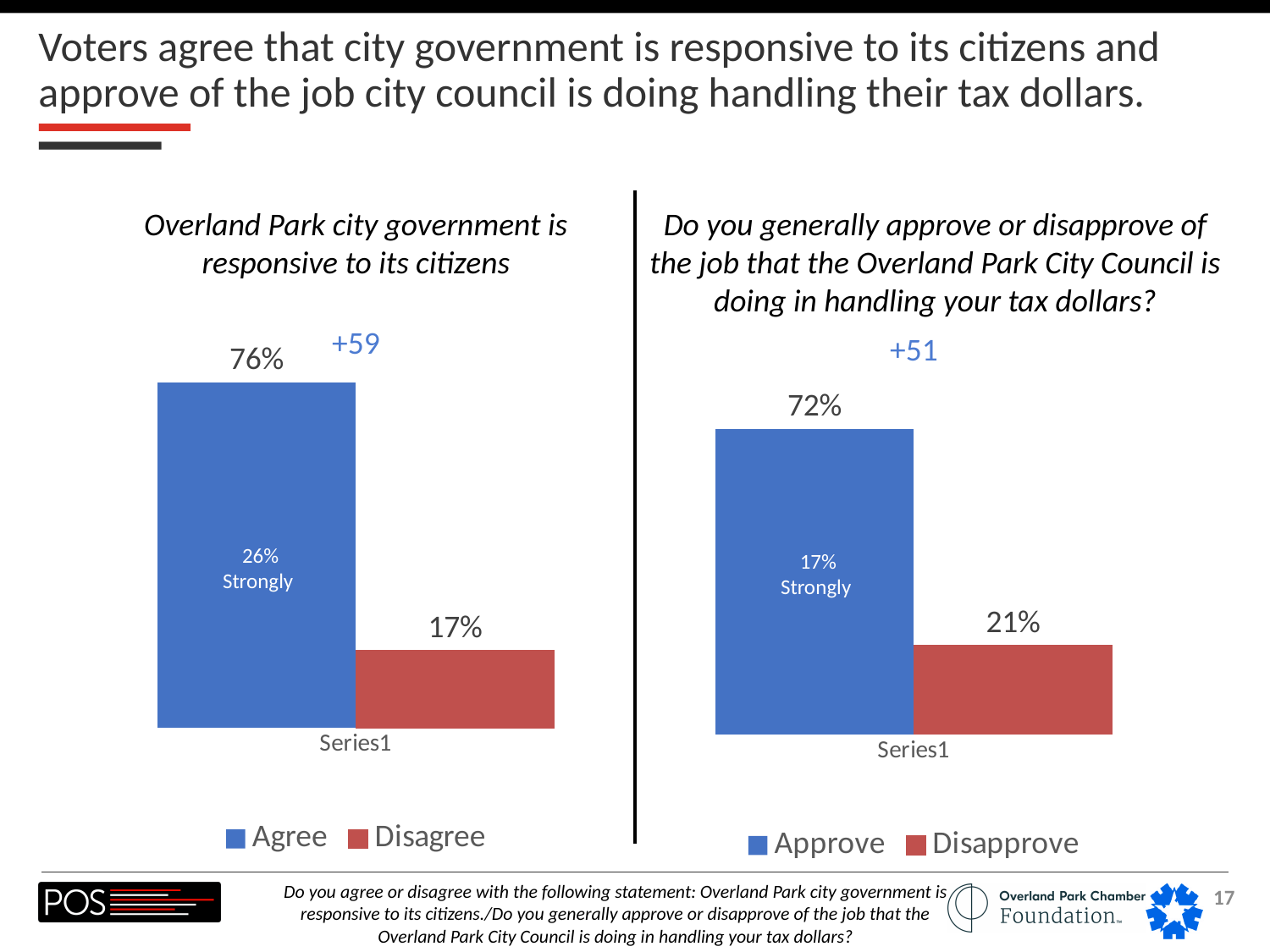
What are the legend entries of the right chart (approve or disapprove of the City Council handling tax dollars)? Approve, Disapprove In the left chart ('Overland Park city government is responsive to its citizens'), what percentage of voters disagree? 17% In the left chart ('Overland Park city government is responsive to its citizens'), what percentage of voters agree? 76% In the left chart ('Overland Park city government is responsive to its citizens'), what percentage strongly agree? 26% What kind of chart is the right chart (approve or disapprove of the City Council handling tax dollars)? Bar chart How many series does the legend of the left chart ('Overland Park city government is responsive to its citizens') list? 2 In the right chart (approve or disapprove of the City Council handling tax dollars), what percentage disapprove? 21% In the left chart ('Overland Park city government is responsive to its citizens'), what is the difference between the Agree and Disagree percentages? +59 In the right chart (approve or disapprove of the City Council handling tax dollars), which is larger, Approve or Disapprove? Approve In the right chart (approve or disapprove of the City Council handling tax dollars), what percentage approve? 72% In the right chart (approve or disapprove of the City Council handling tax dollars), what is the difference between the Approve and Disapprove percentages? +51 In the right chart (approve or disapprove of the City Council handling tax dollars), what percentage strongly approve? 17%